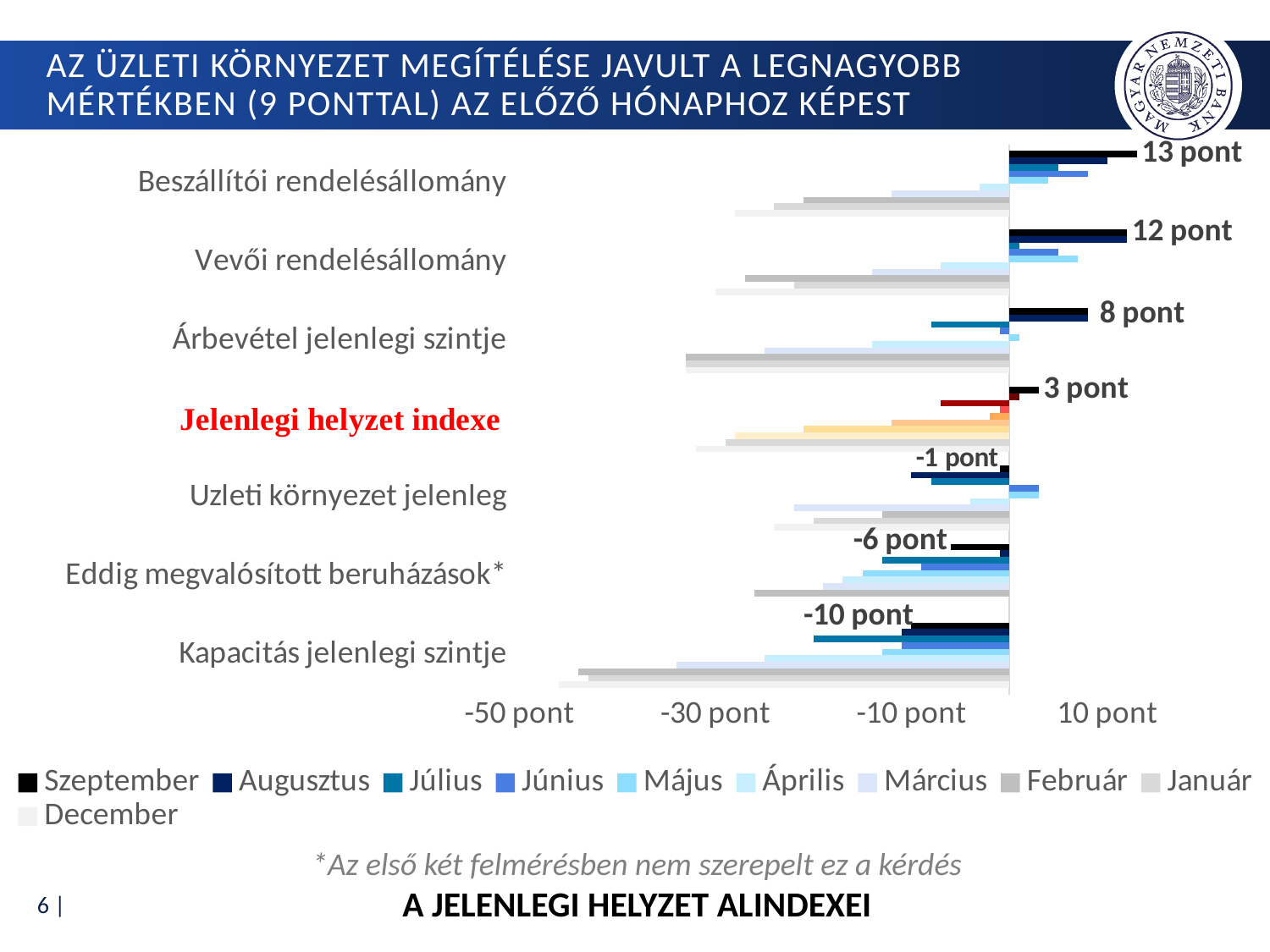
Is the December value for Kapacitás jelenlegi szintje greater or less than -30 pont? less Which category has the lowest Szeptember value? Kapacitás jelenlegi szintje How many series does the legend list? 10 How many categories are shown on the chart? 7 What is the Szeptember value for Beszállítói rendelésállomány? 13 pont What kind of chart is shown on the slide? bar chart What is the Szeptember value for Jelenlegi helyzet indexe? 3 pont Which is larger, the Szeptember value for Árbevétel jelenlegi szintje or for Uzleti környezet jelenleg? Árbevétel jelenlegi szintje Which category has the highest Szeptember value? Beszállítói rendelésállomány What is the difference between the Szeptember values for Beszállítói rendelésállomány and Vevői rendelésállomány? 1 pont What is the Szeptember value for Kapacitás jelenlegi szintje? -10 pont What is the Szeptember value for Vevői rendelésállomány? 12 pont